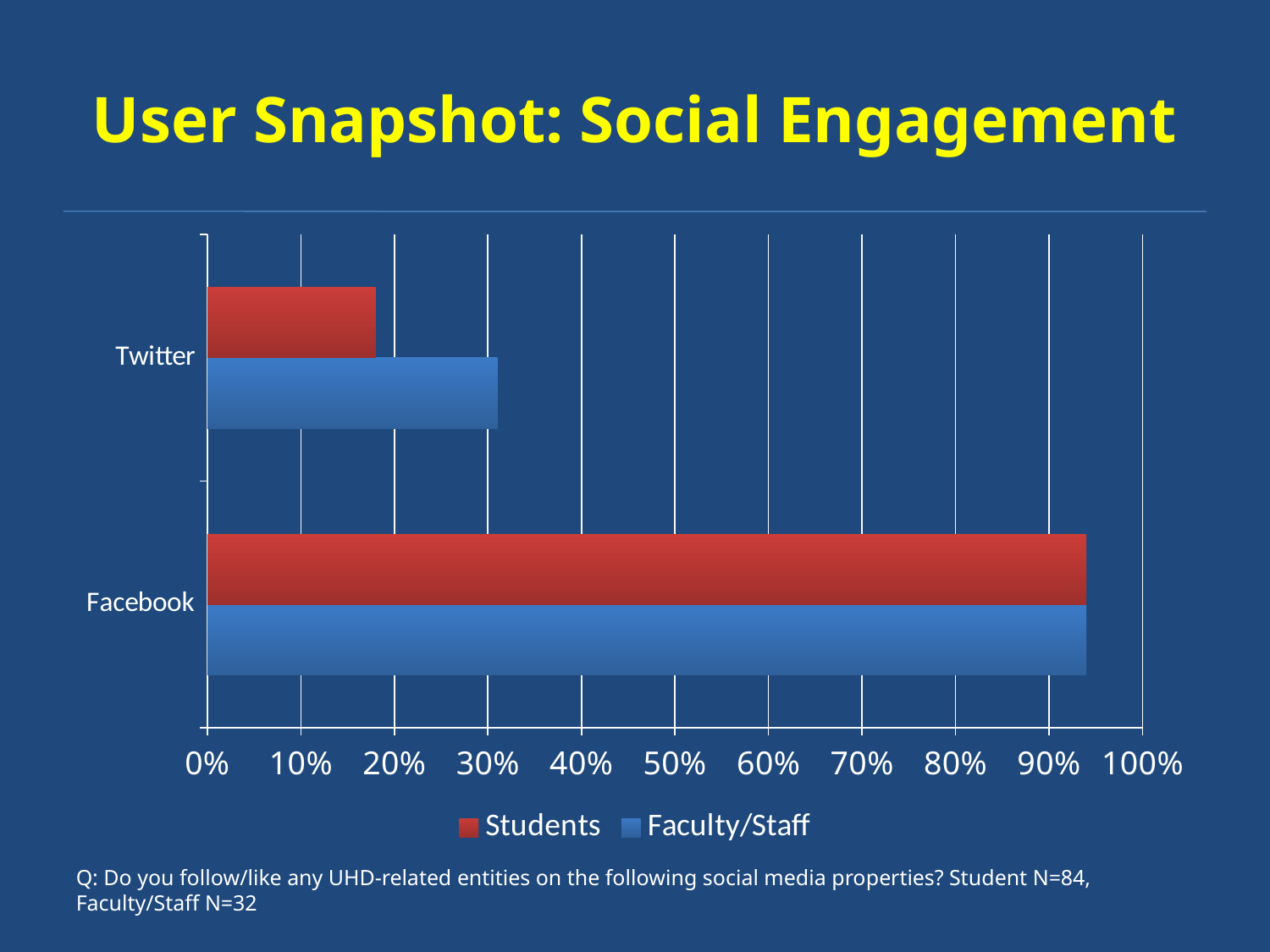
What kind of chart is shown on the slide? Bar chart Is the Students value for Facebook greater or less than 90%? greater Is the Faculty/Staff value for Twitter greater or less than 20%? greater How many social media categories are shown on the chart? 2 How many series does the legend list? 2 Which series does the red bar represent? Students Which social media category has the lowest Faculty/Staff value? Twitter For Twitter, which is larger: the Students value or the Faculty/Staff value? Faculty/Staff Is the Students value for Twitter greater or less than 20%? less Which social media category has the highest Students value? Facebook What is the title of the slide containing the chart? User Snapshot: Social Engagement